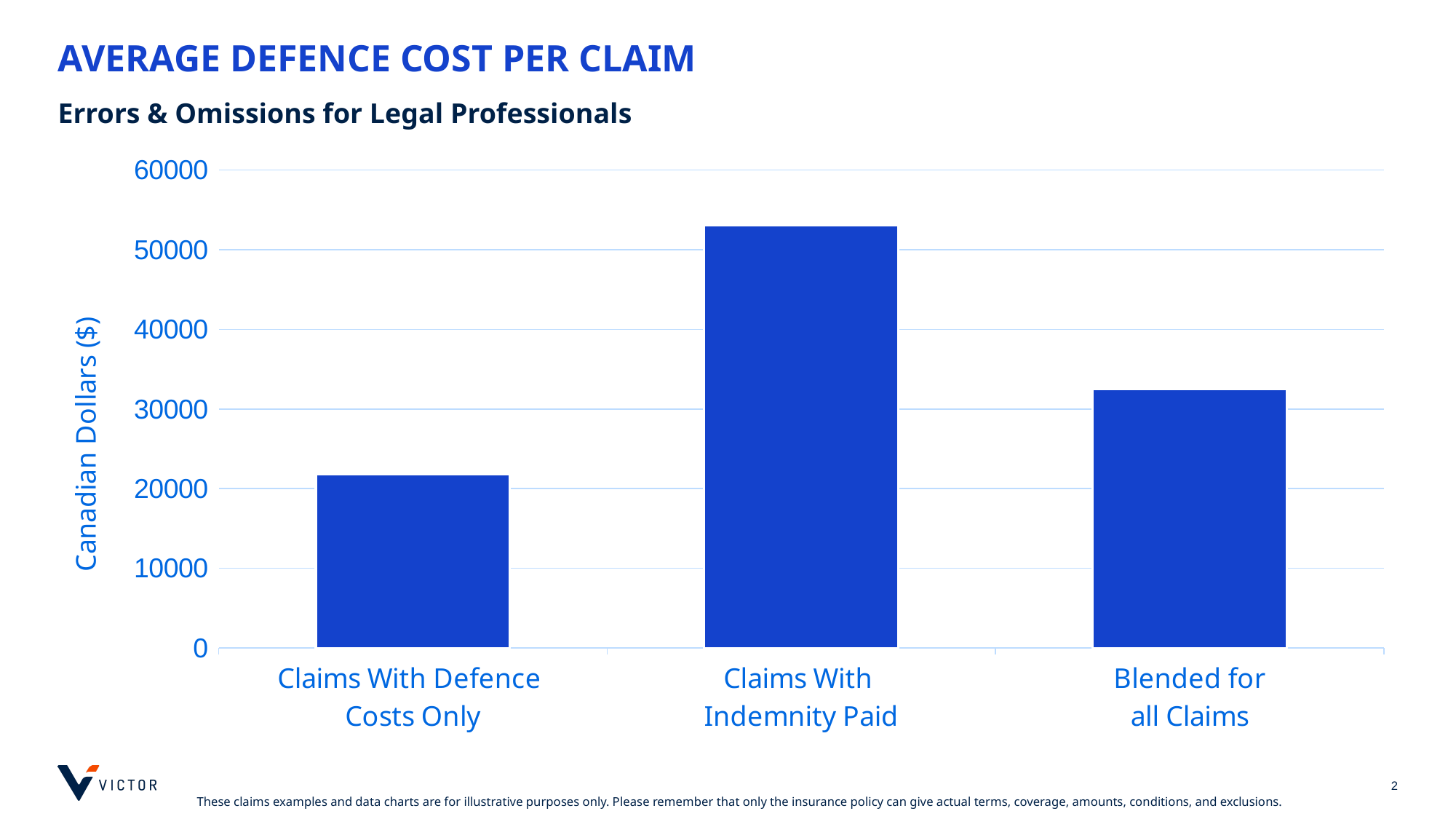
Which is larger, the value for Claims With Indemnity Paid or the value for Blended for all Claims? Claims With Indemnity Paid Which category has the lowest average defence cost per claim? Claims With Defence Costs Only Is the value for Blended for all Claims greater or less than 40000? less Is the value for Blended for all Claims greater or less than 30000? greater What kind of chart is shown on the slide? bar chart Is the value for Claims With Indemnity Paid greater or less than 50000? greater Which category has the highest average defence cost per claim? Claims With Indemnity Paid How many categories are plotted in the chart? 3 What is the title of the slide containing the chart? AVERAGE DEFENCE COST PER CLAIM What is the label of the vertical axis? Canadian Dollars ($) Which is larger, the value for Blended for all Claims or the value for Claims With Defence Costs Only? Blended for all Claims